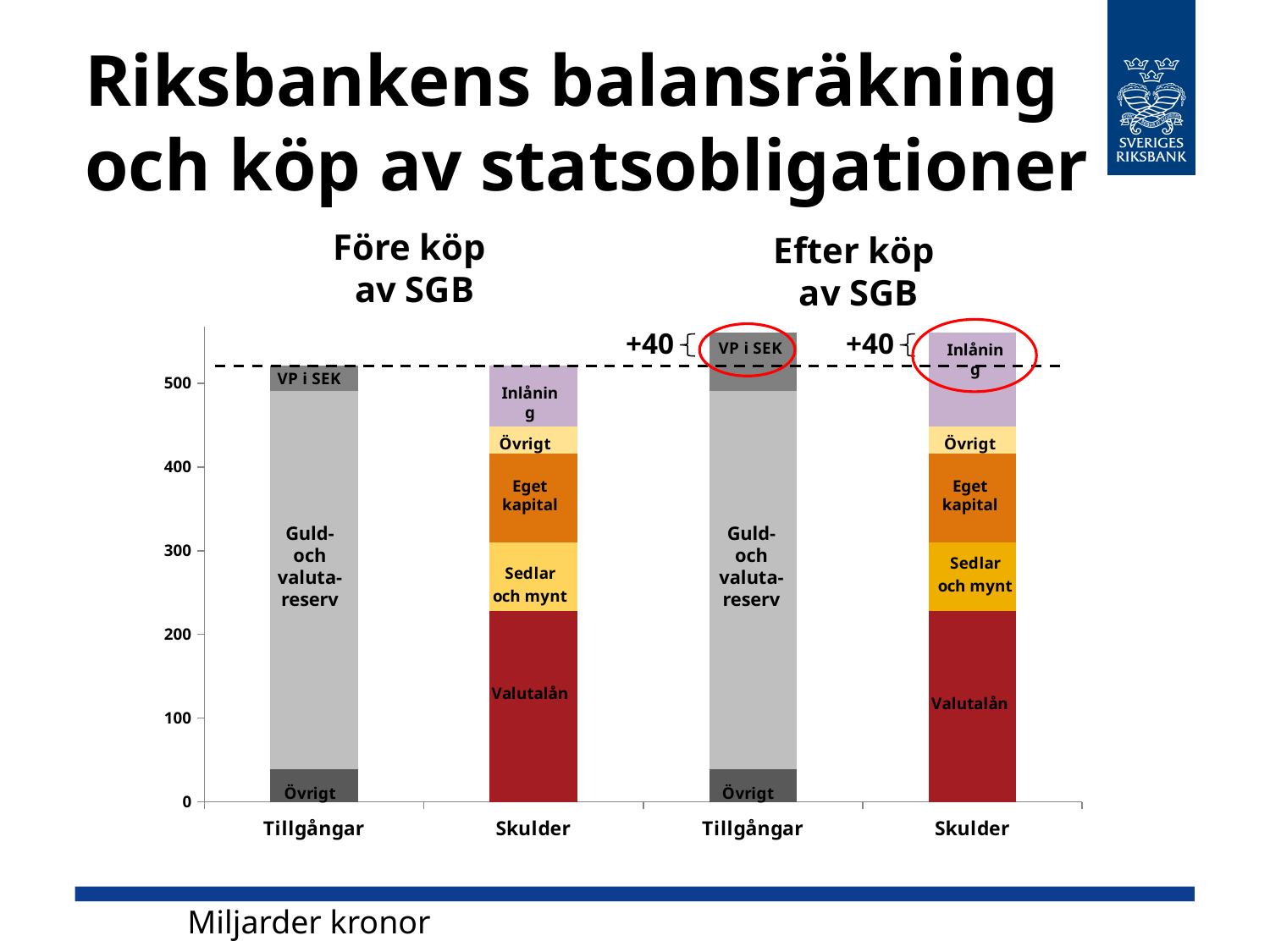
Which segment is the largest in the Tillgångar bar before the purchase of SGB? Guld- och valutareserv Is the Övrigt segment at the bottom of the Tillgångar bar before the purchase of SGB greater or less than 100? less By how much does the chart indicate the Tillgångar bar increases after the purchase of SGB? +40 Which segment of the Skulder bar after the purchase of SGB is circled in red? Inlåning What kind of chart is shown on the slide? Stacked bar chart Which segment is at the bottom of the Skulder bar after the purchase of SGB? Valutalån Which is larger: the Tillgångar bar before the purchase of SGB or the Tillgångar bar after the purchase of SGB? After the purchase of SGB What unit is given for the values in the chart? Miljarder kronor Is the top of the Valutalån segment in the Skulder bar before the purchase of SGB greater or less than 200? greater How many bars are plotted in the chart? 4 Is the total of the Tillgångar bar after the purchase of SGB greater or less than 500? greater What is the title of the slide containing the chart? Riksbankens balansräkning och köp av statsobligationer